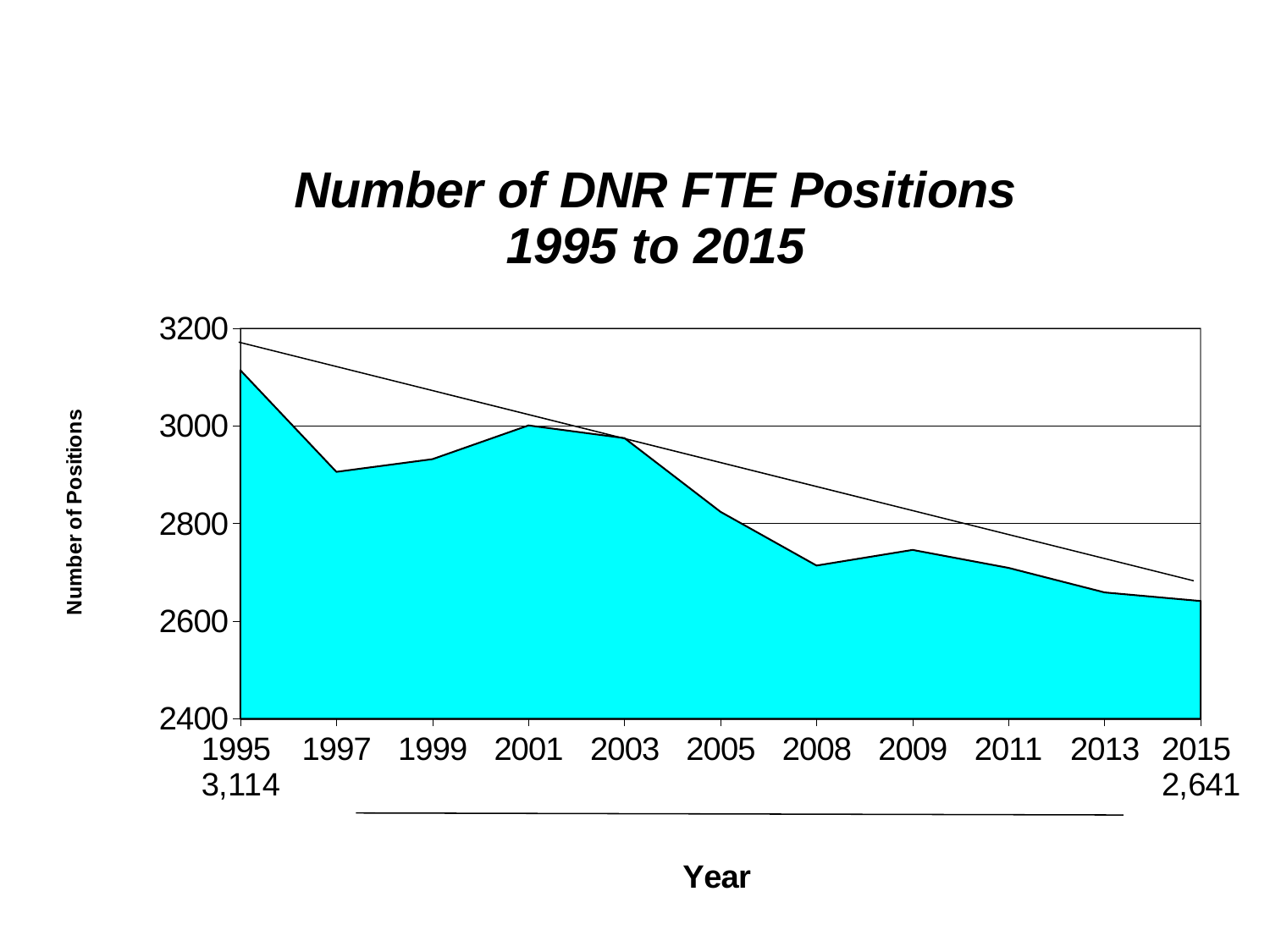
What is the number of DNR FTE positions in 2015? 2,641 What is the label on the vertical axis of the chart? Number of Positions How many years are plotted on the x axis of the chart? 11 Which year has more DNR FTE positions, 1997 or 2001? 2001 Overall, do the number of DNR FTE positions rise or fall from 1995 to 2015? fall Is the number of positions in 2008 greater or less than 2800? less Is the number of positions in 2011 greater or less than 2600? greater By how much did the number of DNR FTE positions fall from 1995 to 2015? 473 What is the number of DNR FTE positions in 1995? 3,114 Which year has more DNR FTE positions, 1995 or 2003? 1995 Is the number of positions in 1997 greater or less than 3000? less Which year has the highest number of DNR FTE positions? 1995